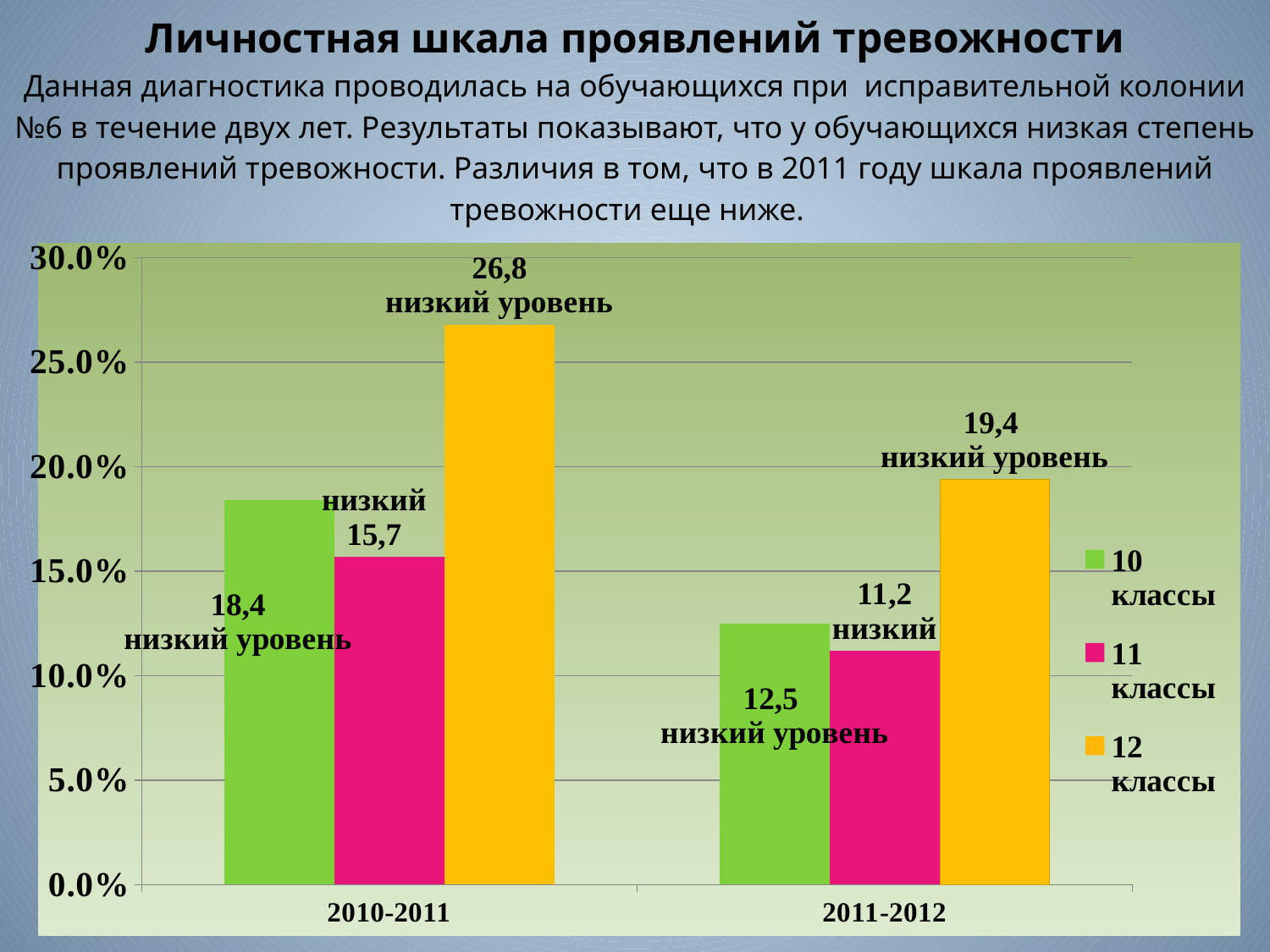
Which is larger: the 10 классы value in 2010-2011 or the 10 классы value in 2011-2012? 2010-2011 Do the values for 11 классы rise or fall from 2010-2011 to 2011-2012? fall How many categories are shown on the x axis? 2 How many series does the legend list? 3 What is the value for 11 классы in 2011-2012? 11,2 What type of chart is shown on the slide? bar chart What is the value for 10 классы in 2010-2011? 18,4 Which series has the lowest value in 2010-2011? 11 классы What is the difference between the 12 классы values for 2010-2011 and 2011-2012? 7,4 What colour are the bars for 12 классы? yellow What is the value for 12 классы in 2010-2011? 26,8 Which series has the highest value in 2011-2012? 12 классы